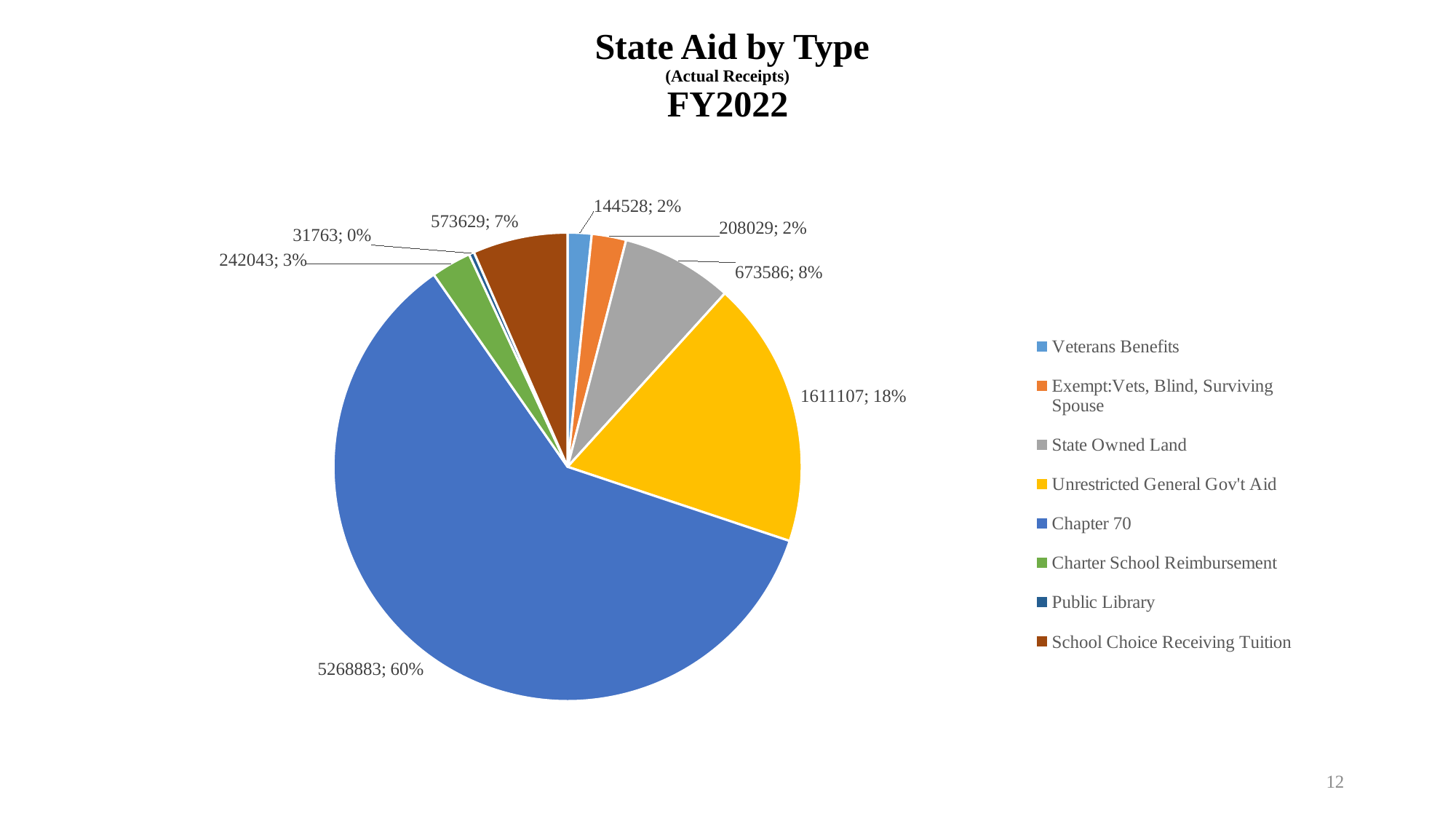
Which is larger, the value for Exempt:Vets, Blind, Surviving Spouse or the value for Veterans Benefits? Exempt:Vets, Blind, Surviving Spouse Which category has the smallest slice of the pie? Public Library What share of the pie does State Owned Land represent? 8% What is the value for Chapter 70? 5268883 What kind of chart is shown on the slide? pie chart What share of the pie does Charter School Reimbursement represent? 3% What is the title of the chart? State Aid by Type (Actual Receipts) FY2022 How many categories does the legend list? 8 Which category has the largest slice of the pie? Chapter 70 What is the value for School Choice Receiving Tuition? 573629 What is the value for Unrestricted General Gov't Aid? 1611107 What is the difference between the values for Unrestricted General Gov't Aid and State Owned Land? 937521